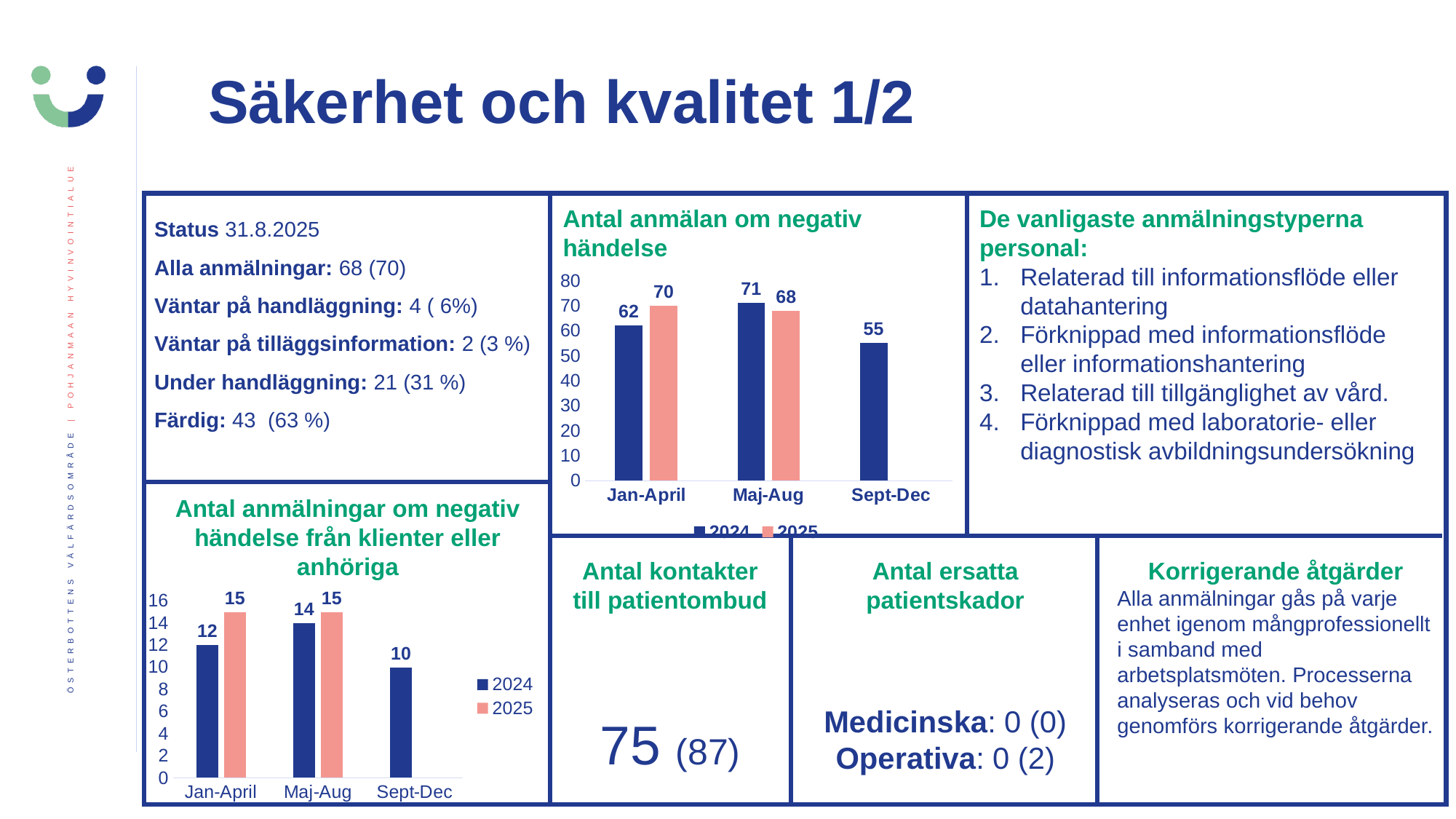
In the chart 'Antal anmälningar om negativ händelse från klienter eller anhöriga', what is the value for 2025 in Jan-April? 15 What kind of chart is 'Antal anmälan om negativ händelse'? Bar chart In the chart 'Antal anmälan om negativ händelse', what is the value for 2024 in Jan-April? 62 In the chart 'Antal anmälningar om negativ händelse från klienter eller anhöriga', how many periods are shown on the x axis? 3 In the chart 'Antal anmälan om negativ händelse', how many series does the legend list? 2 In the chart 'Antal anmälan om negativ händelse', what is the value for 2025 in Maj-Aug? 68 In the chart 'Antal anmälningar om negativ händelse från klienter eller anhöriga', which colour represents 2025? Pink (salmon) In the chart 'Antal anmälan om negativ händelse', what is the difference between the 2025 and 2024 values in Jan-April? 8 In the chart 'Antal anmälan om negativ händelse', which is larger in Maj-Aug: 2024 or 2025? 2024 In the chart 'Antal anmälan om negativ händelse', which period has the lowest value for 2024? Sept-Dec In the chart 'Antal anmälningar om negativ händelse från klienter eller anhöriga', what is the difference between the 2025 and 2024 values in Jan-April? 3 In the chart 'Antal anmälningar om negativ händelse från klienter eller anhöriga', what is the value for 2024 in Maj-Aug? 14